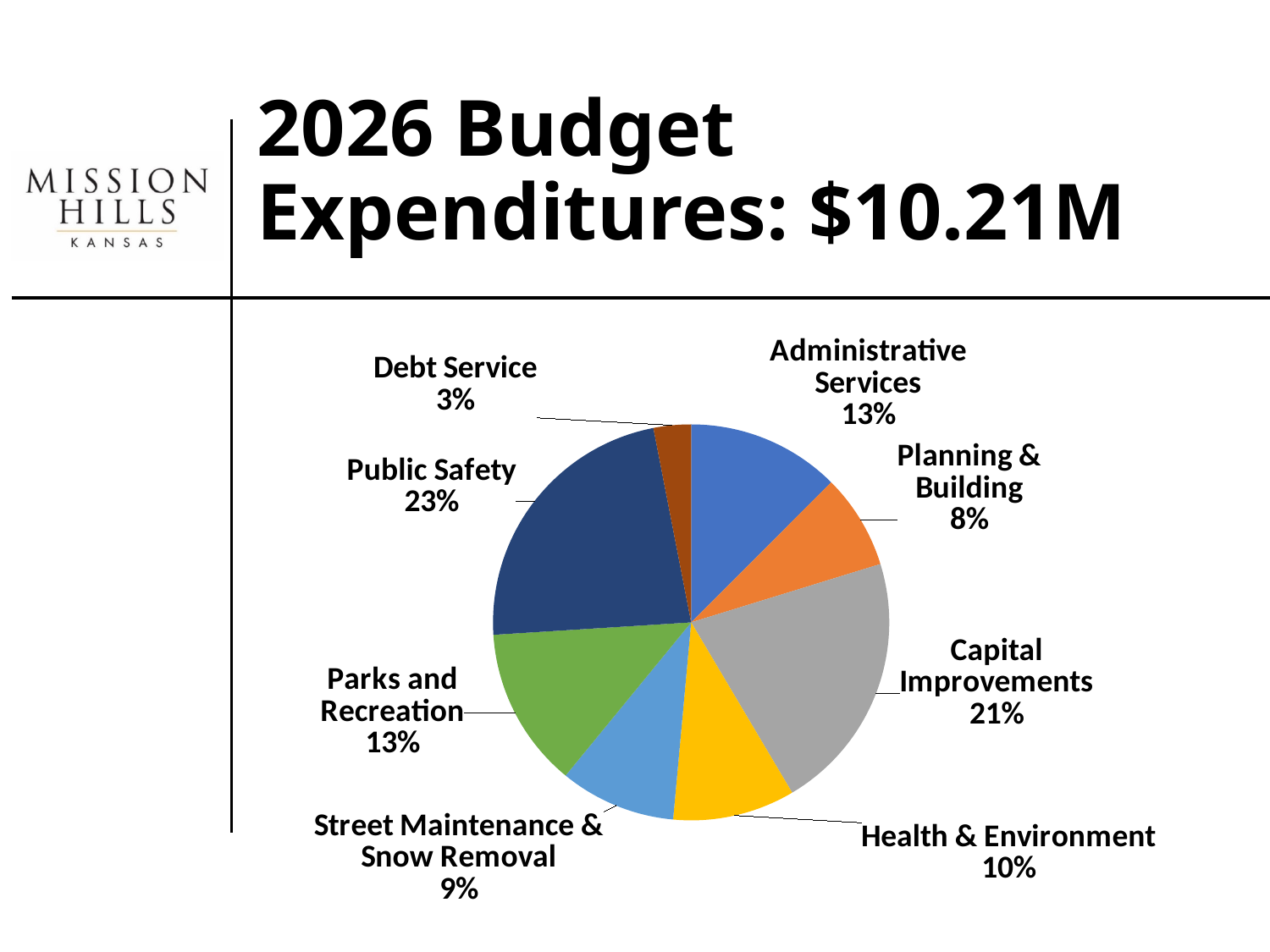
What is the total 2026 budget expenditure amount stated in the slide title? $10.21M What percentage of expenditures is allocated to Capital Improvements? 21% What type of chart is shown on the slide? Pie chart What share of the pie is Debt Service? 3% Which category has the smallest share of the 2026 budget expenditures? Debt Service What percentage is shown for Street Maintenance & Snow Removal? 9% What share of the 2026 budget expenditures goes to Public Safety? 23% What is the difference in percentage points between Public Safety and Capital Improvements? 2% Which two categories each account for 13% of expenditures? Administrative Services and Parks and Recreation Which category has the largest share of the 2026 budget expenditures? Public Safety How many categories are shown in the pie chart? 8 Which is larger, the share for Health & Environment or the share for Planning & Building? Health & Environment